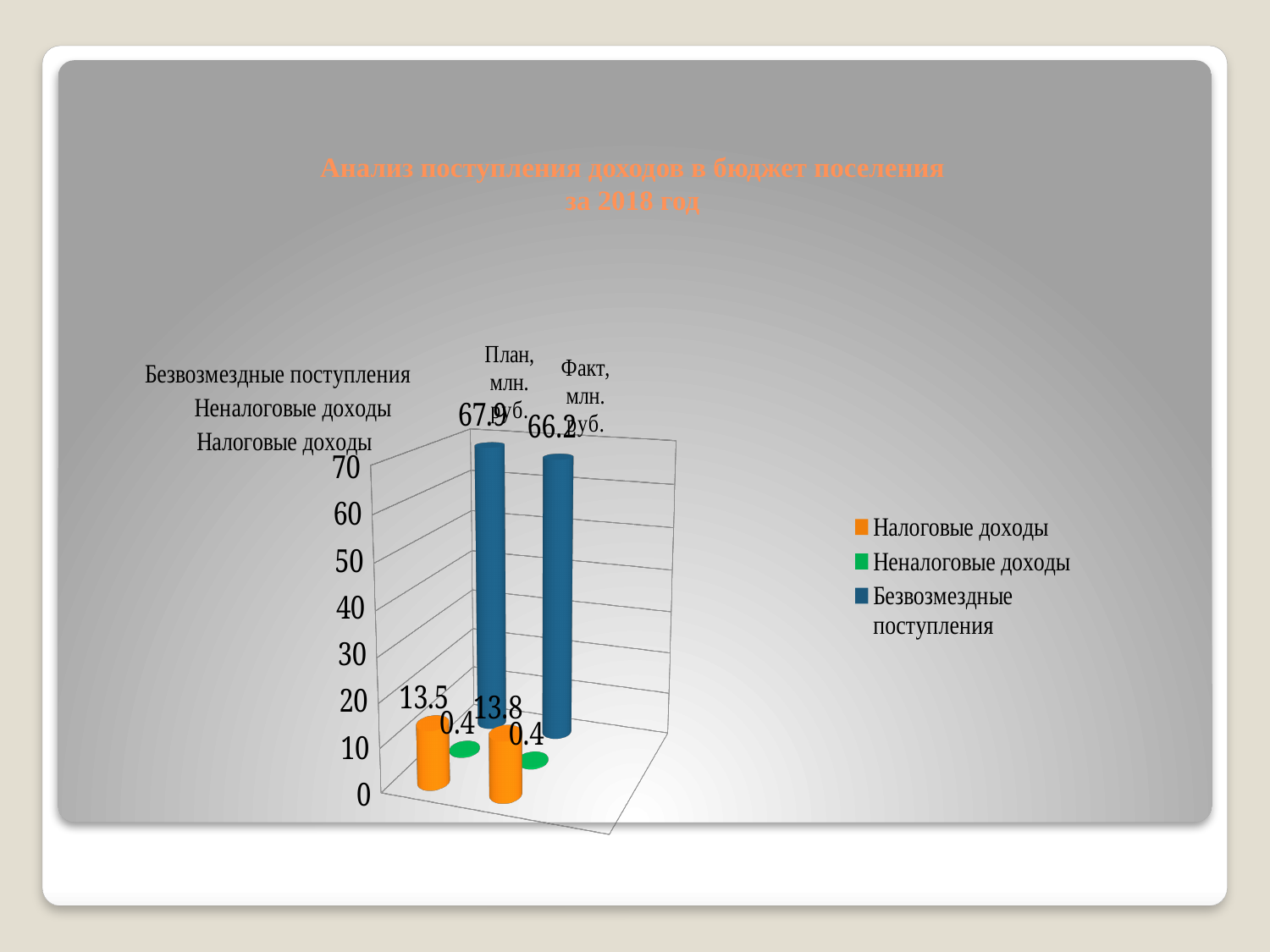
What is the title of the slide? Анализ поступления доходов в бюджет поселения за 2018 год What is the value of Безвозмездные поступления for План, млн. руб.? 67.9 How many series does the legend list? 3 What is the value of Налоговые доходы for План, млн. руб.? 13.5 What is the difference between the План and Факт values for Безвозмездные поступления? 1.7 What type of chart is shown on the slide? bar chart What is the value of Неналоговые доходы for Факт, млн. руб.? 0.4 What is the value of Безвозмездные поступления for Факт, млн. руб.? 66.2 What is the value of Налоговые доходы for Факт, млн. руб.? 13.8 Which series has the highest value for План, млн. руб.? Безвозмездные поступления Is the value of Безвозмездные поступления for Факт, млн. руб. greater or less than 60? greater Which series has the lowest value for Факт, млн. руб.? Неналоговые доходы